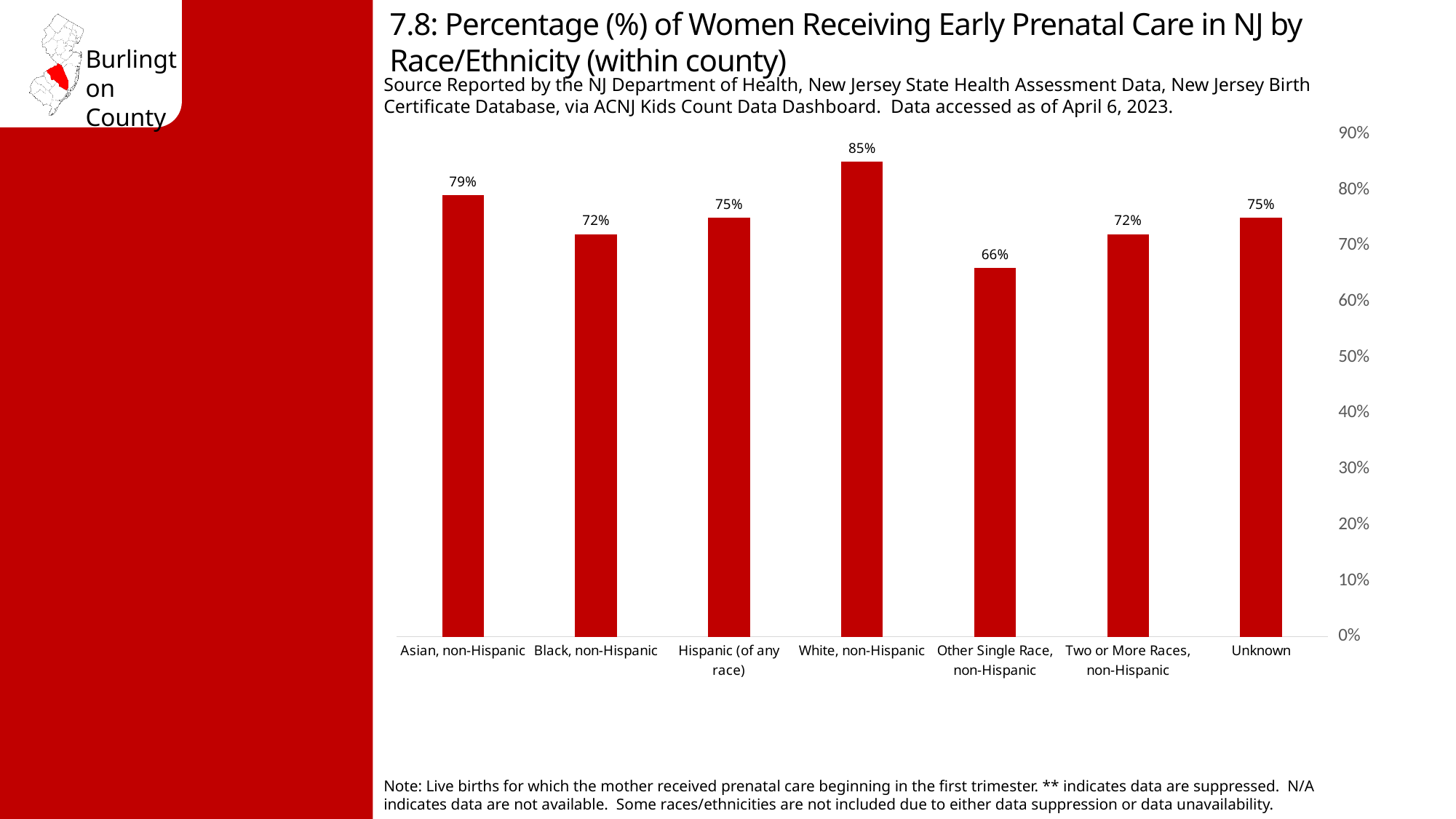
What kind of chart is shown on the slide? Bar chart Which is larger, the value for Hispanic (of any race) or the value for Two or More Races, non-Hispanic? Hispanic (of any race) Which race/ethnicity category has the lowest percentage? Other Single Race, non-Hispanic How many race/ethnicity categories are shown on the chart? 7 What is the value shown for Other Single Race, non-Hispanic? 66% What is the difference between the values for Asian, non-Hispanic and Black, non-Hispanic? 7% Which race/ethnicity category has the highest percentage? White, non-Hispanic What is the difference between the values for White, non-Hispanic and Other Single Race, non-Hispanic? 19% What is the value shown for Unknown? 75% What percentage of Asian, non-Hispanic women received early prenatal care? 79% Is the value for Black, non-Hispanic greater or less than 80%? less What is the value shown for White, non-Hispanic? 85%